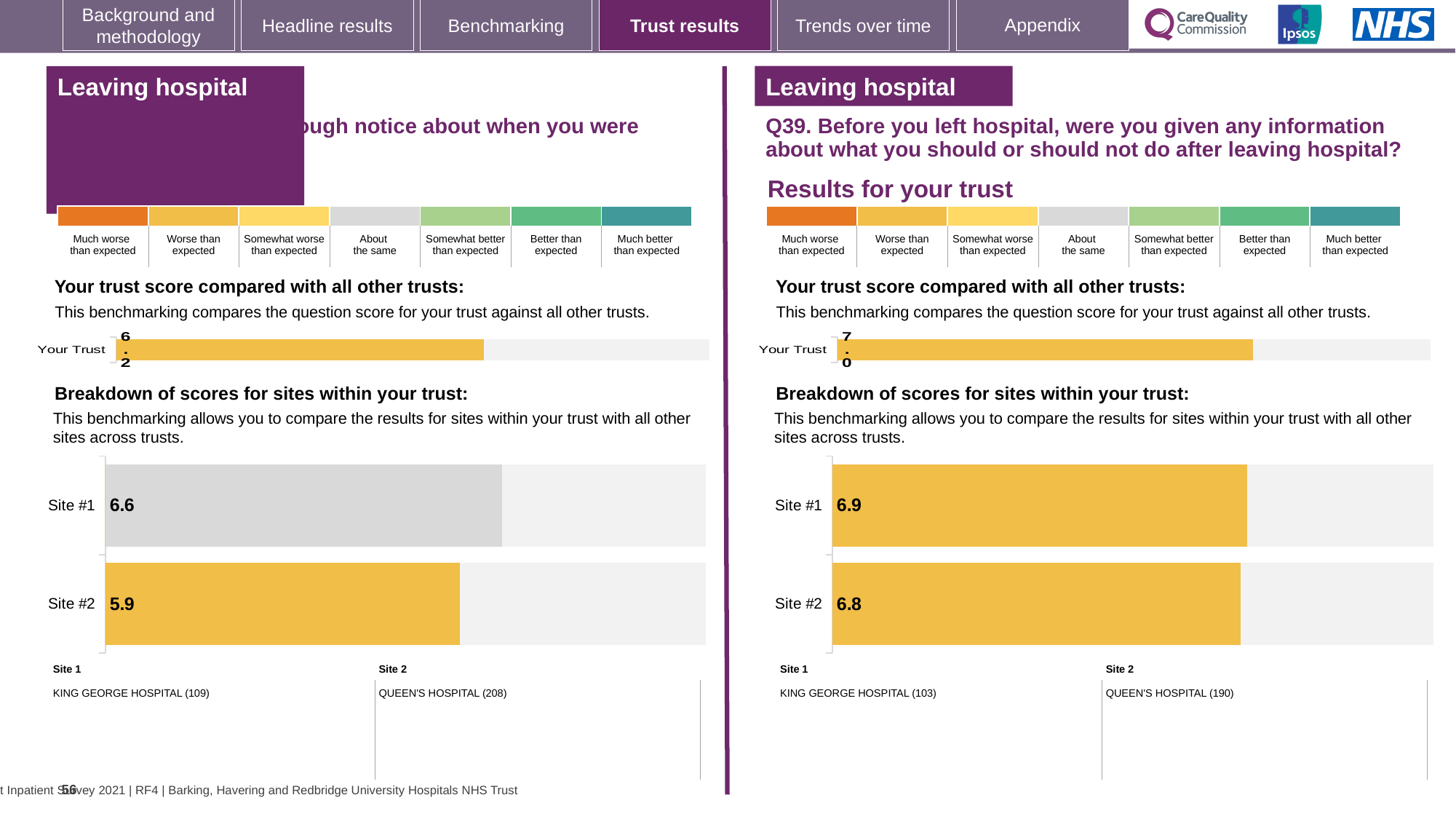
In the site breakdown chart on the left-hand half of the slide, what is the score for Site #1? 6.6 On the right-hand (Q39) slide half, what is the 'Your Trust' score shown in the trust benchmarking bar? 7.0 In the Q39 site breakdown chart on the right, what is the score for Site #1? 6.9 In the site breakdown chart on the left-hand half of the slide, which site has the lower score? Site #2 In the site breakdown chart on the left-hand half of the slide, what colour is the Site #1 bar? Grey What type of chart is used for the site breakdown on the right-hand half of the slide? Bar chart In the site breakdown chart on the left-hand half of the slide, what is the score for Site #2? 5.9 In the site breakdown chart on the left-hand half of the slide, what is the difference between the Site #1 and Site #2 scores? 0.7 How many sites are shown in the Q39 site breakdown chart on the right? 2 On the left-hand slide half, what is the 'Your Trust' score shown in the trust benchmarking bar? 6.2 In the Q39 site breakdown chart on the right, what is the score for Site #2? 6.8 In the Q39 site breakdown chart on the right, what is the difference between the Site #1 and Site #2 scores? 0.1